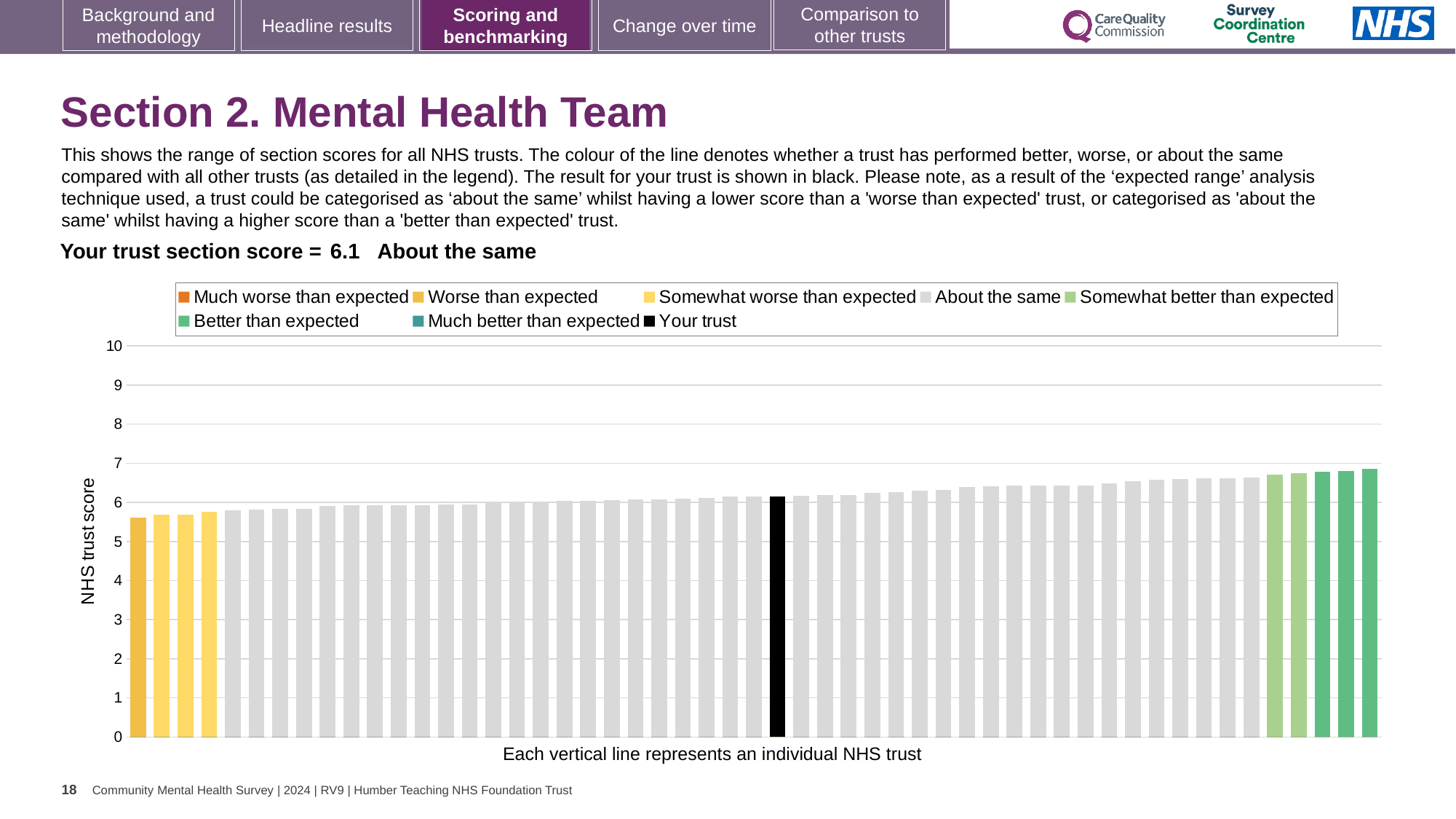
Do the bar values rise or fall from left to right along the x axis? rise What colour is the bar representing your trust? black Is the value of the lowest bar greater or less than 6? less What is the label on the vertical axis of the chart? NHS trust score How many entries does the chart legend list? 8 What is the section score for your trust shown on the slide? 6.1 What kind of chart is shown on the slide? bar chart Which is larger, the value for your trust or the value of the leftmost bar? your trust Is the value for your trust greater or less than 5? greater Is the value of the highest bar greater or less than 6? greater How many bars are coloured as 'Better than expected' (dark green)? 3